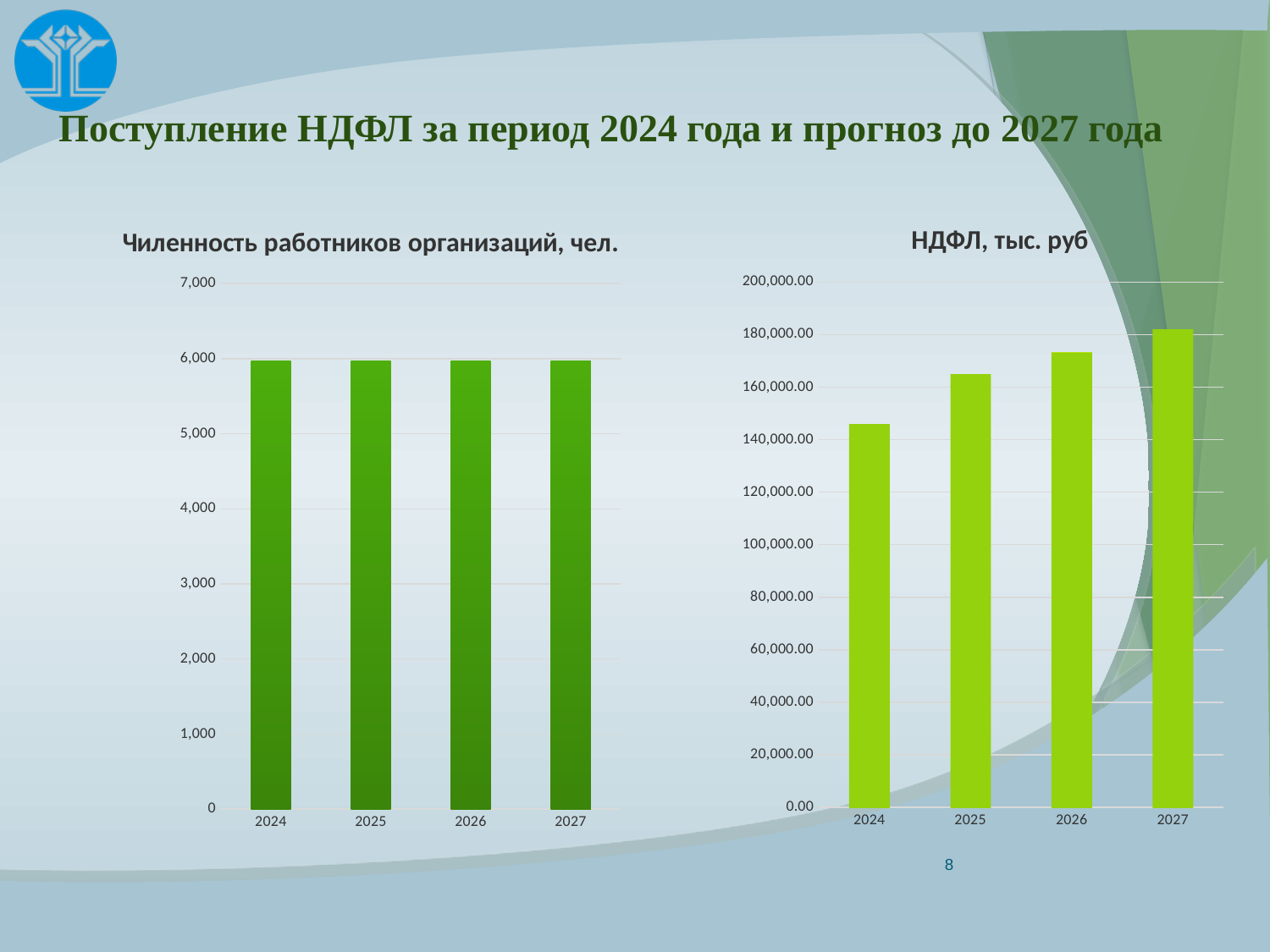
In the chart titled "НДФЛ, тыс. руб", is the value for 2024 greater or less than 160,000.00? less What kind of chart is the chart titled "НДФЛ, тыс. руб"? bar chart In the chart titled "НДФЛ, тыс. руб", how many years are shown on the x axis? 4 In the chart titled "НДФЛ, тыс. руб", which year has the lowest value? 2024 What kind of chart is the chart titled "Чиленность работников организаций, чел."? bar chart In the chart titled "НДФЛ, тыс. руб", which year has the highest value? 2027 In the chart titled "НДФЛ, тыс. руб", do the values rise or fall from 2024 to 2027? rise In the chart titled "НДФЛ, тыс. руб", is the value for 2026 greater or less than 160,000.00? greater In the chart titled "Чиленность работников организаций, чел.", is the value for 2024 greater or less than 5,000? greater What is the title of the chart on the right side of the slide? НДФЛ, тыс. руб In the chart titled "НДФЛ, тыс. руб", which is larger, the value for 2025 or the value for 2027? 2027 In the chart titled "Чиленность работников организаций, чел.", how many bars are plotted? 4